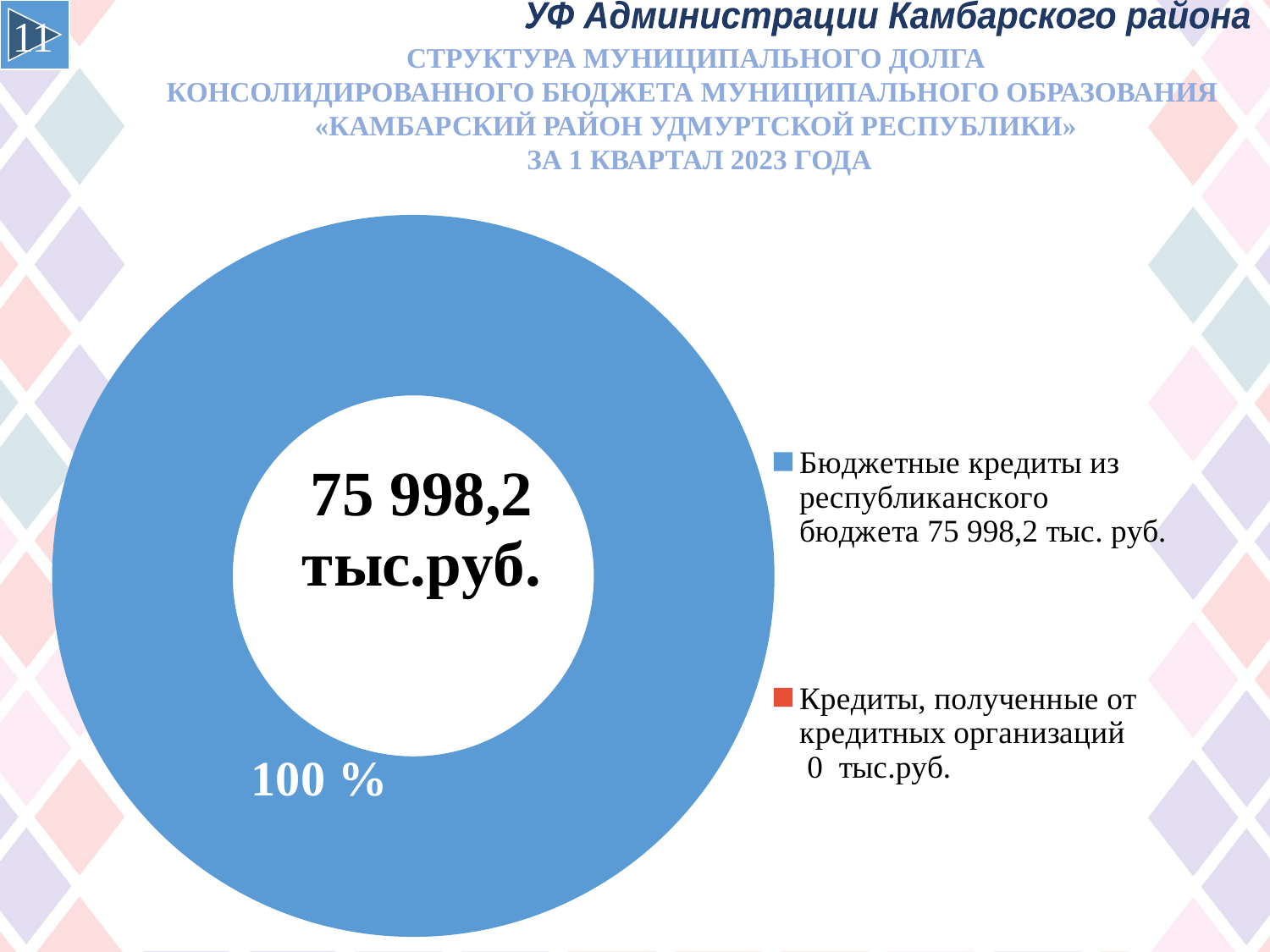
What value is shown for 'Бюджетные кредиты из республиканского бюджета'? 75 998,2 тыс. руб. How many series does the legend list? 2 What value is shown for 'Кредиты, полученные от кредитных организаций'? 0 тыс.руб. What share of the chart does the blue segment represent? 100 % For which period does the chart show the municipal debt structure? 1 квартал 2023 года What total value is printed in the centre of the doughnut chart? 75 998,2 тыс.руб. What colour represents 'Бюджетные кредиты из республиканского бюджета' in the legend? Blue What is the difference between the value for budget credits from the republican budget and credits from credit organisations? 75 998,2 тыс. руб. Which category has the largest value? Бюджетные кредиты из республиканского бюджета What kind of chart is shown on the slide? Doughnut (pie) chart Which category has the smallest value? Кредиты, полученные от кредитных организаций Which is larger: budget credits from the republican budget or credits from credit organisations? Бюджетные кредиты из республиканского бюджета